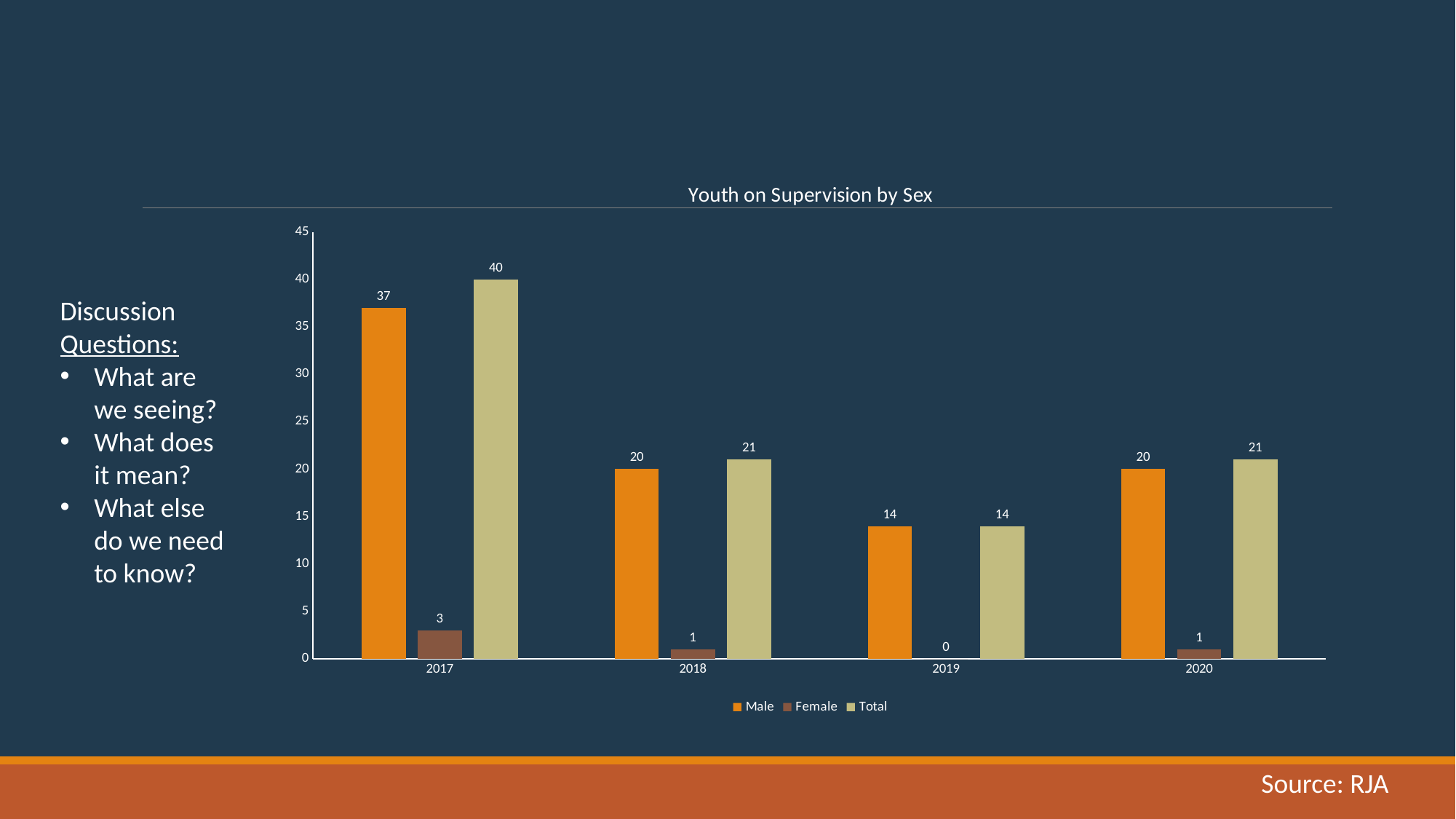
Which year has the highest Total value? 2017 What is the Male value for 2017? 37 What kind of chart is shown? Bar chart What is the title of the chart? Youth on Supervision by Sex Does the Total value rise or fall from 2017 to 2019? Fall Which is larger, the Female value for 2017 or the Female value for 2020? 2017 How many years are shown on the x axis? 4 What is the difference between the Male values for 2017 and 2018? 17 What is the Female value for 2019? 0 How many series does the legend list? 3 What is the Total value for 2018? 21 Which year has the lowest Male value? 2019